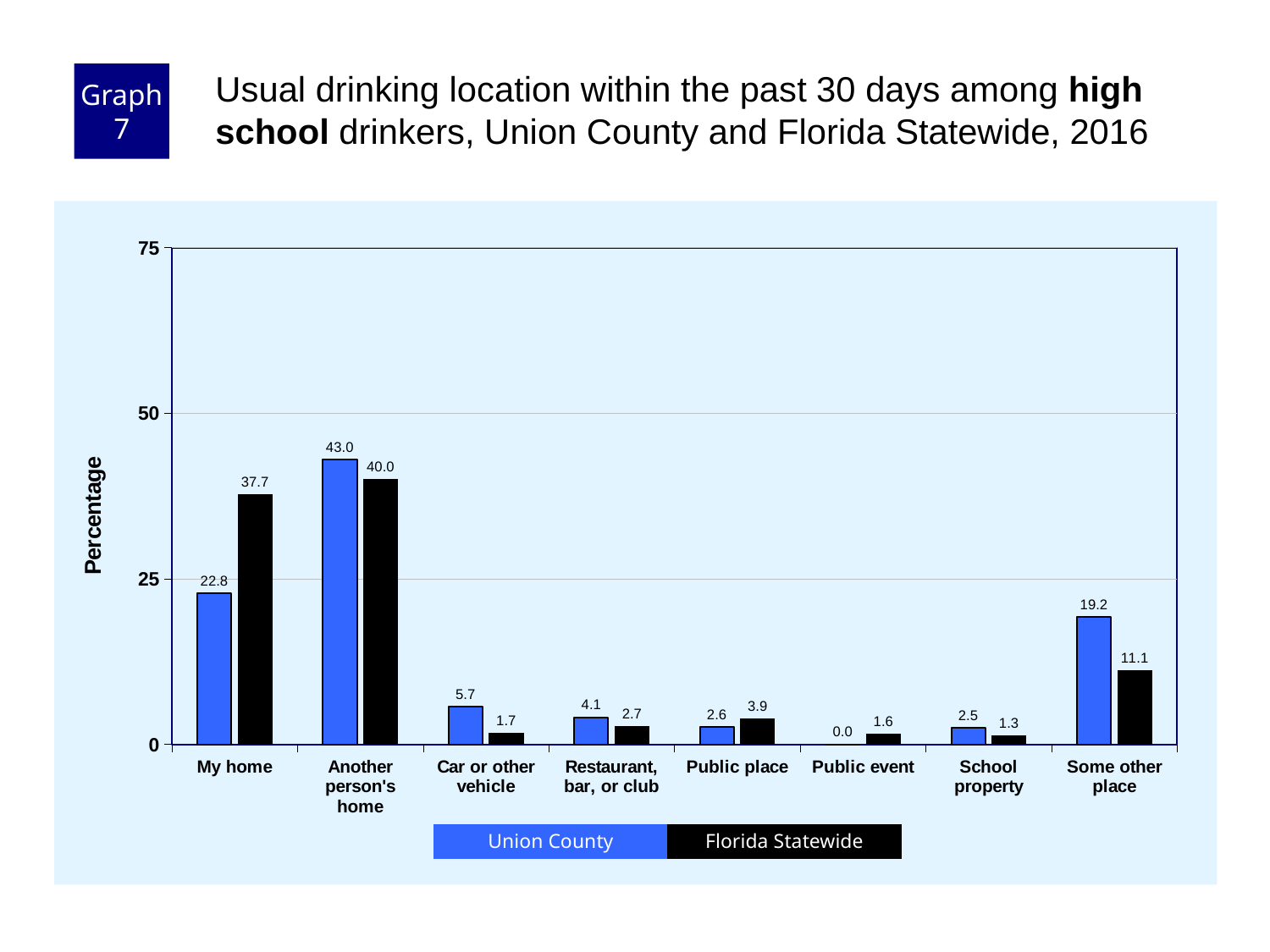
Which category has the highest Union County value? Another person's home Which category has the lowest Florida Statewide value? School property What is the difference between the Union County and Florida Statewide values for "Some other place"? 8.1 Which is larger for "Public place": Union County or Florida Statewide? Florida Statewide What is the Union County value for "Another person's home"? 43.0 How many categories are shown on the x axis? 8 How many series does the legend list? 2 What is the Union County value for "Public event"? 0.0 Is the Union County value for "My home" greater or less than 25? less What is the label of the y axis? Percentage What kind of chart is shown on the slide? Bar chart What is the Florida Statewide value for "My home"? 37.7